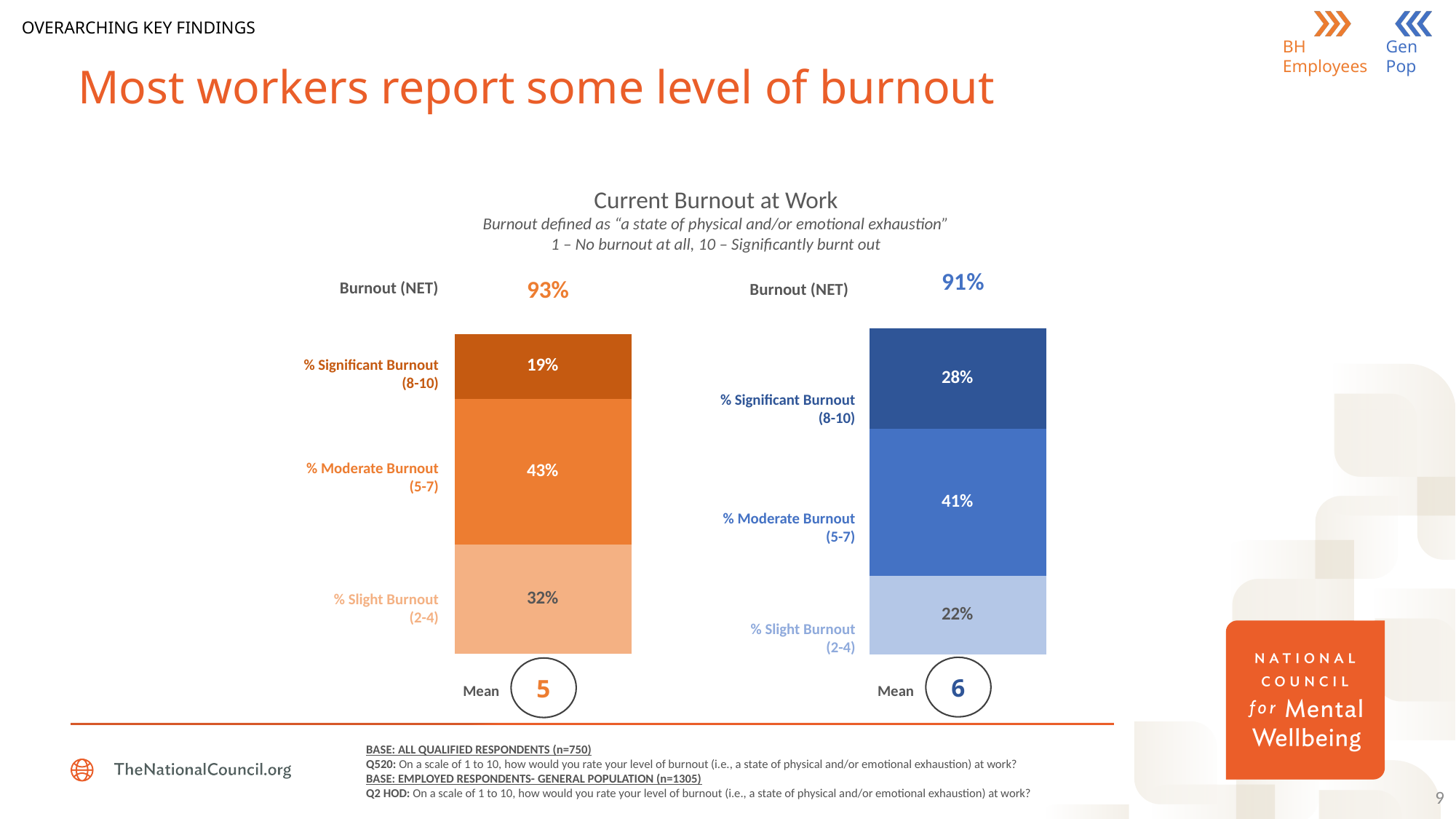
In the Current Burnout at Work chart, what is the difference between the Significant Burnout share for the Gen Pop and for BH Employees? 9 percentage points In the Current Burnout at Work chart, what percentage of the Gen Pop report Moderate Burnout (5-7)? 41% What type of chart is used to show Current Burnout at Work? Stacked bar chart In the Current Burnout at Work chart, what colour is used for the Gen Pop bar? Blue In the Current Burnout at Work chart, what is the total of the three segments in the BH Employees stacked bar? 94% In the Current Burnout at Work chart, which burnout level has the largest share among BH Employees? % Moderate Burnout (5-7) In the Current Burnout at Work chart, what is the Burnout (NET) value for BH Employees? 93% In the Current Burnout at Work chart, what percentage of BH Employees report Significant Burnout (8-10)? 19% In the Current Burnout at Work chart, what is the mean burnout score shown for the Gen Pop? 6 How many burnout level segments make up each stacked bar in the Current Burnout at Work chart? 3 In the Current Burnout at Work chart, which burnout level has the smallest share among the Gen Pop? % Slight Burnout (2-4) In the Current Burnout at Work chart, which group has the higher Slight Burnout (2-4) share, BH Employees or Gen Pop? BH Employees